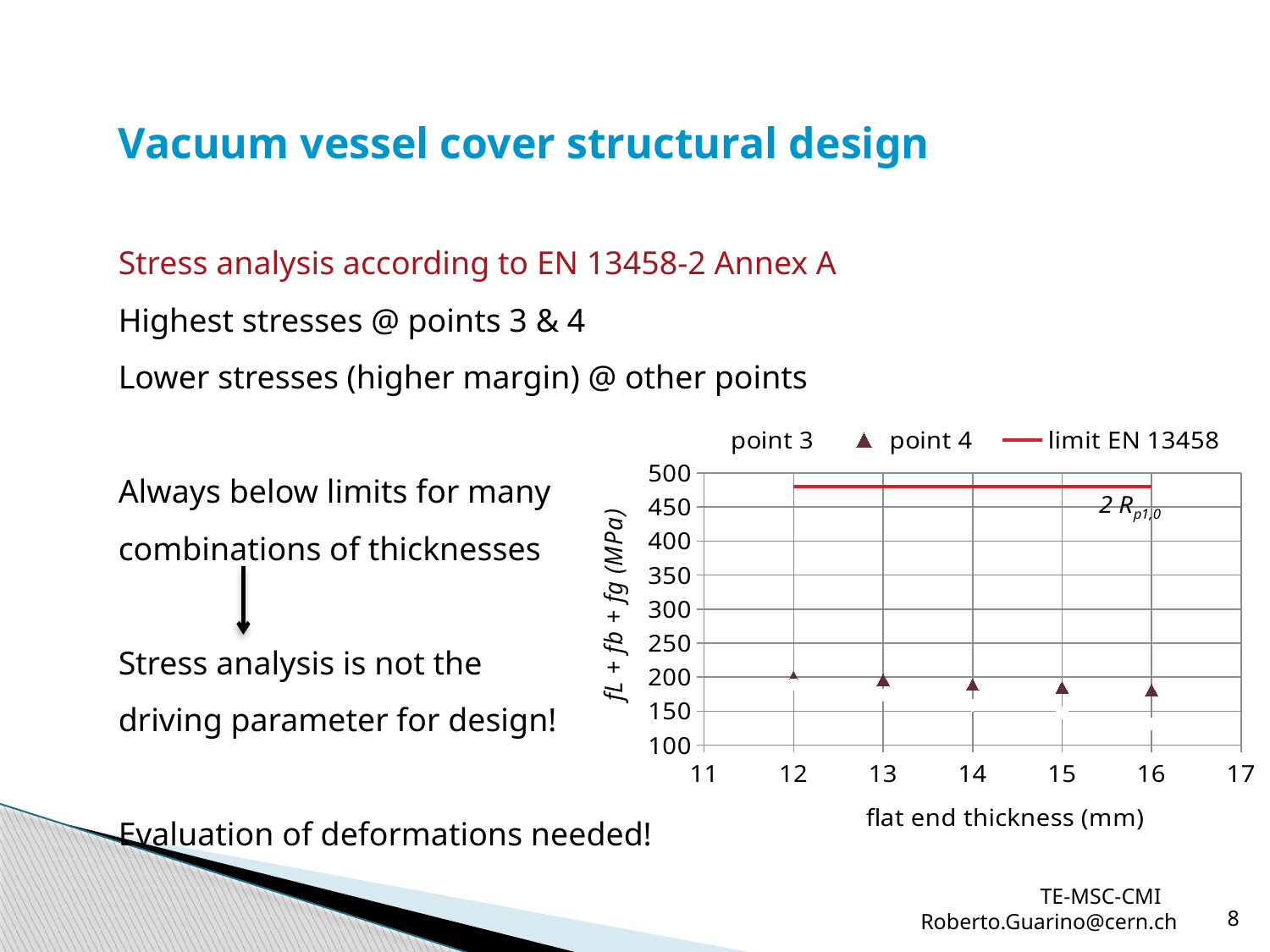
Is the point 4 value at a flat end thickness of 16 mm greater or less than 200? less Is the point 4 value at a flat end thickness of 12 mm greater or less than 150? greater Is the limit EN 13458 line greater or less than 400? greater At which flat end thickness is the point 4 value lowest? 16 How many flat end thickness values are plotted for point 4? 5 Which is larger for point 4: the value at 12 mm or the value at 16 mm? 12 mm What colour is the limit EN 13458 line in the chart? red What is the x-axis title of the chart? flat end thickness (mm) How many series does the chart legend list? 3 What kind of chart is shown on the slide? scatter chart At which flat end thickness is the point 4 value highest? 12 Do the point 4 values rise or fall as flat end thickness increases? fall